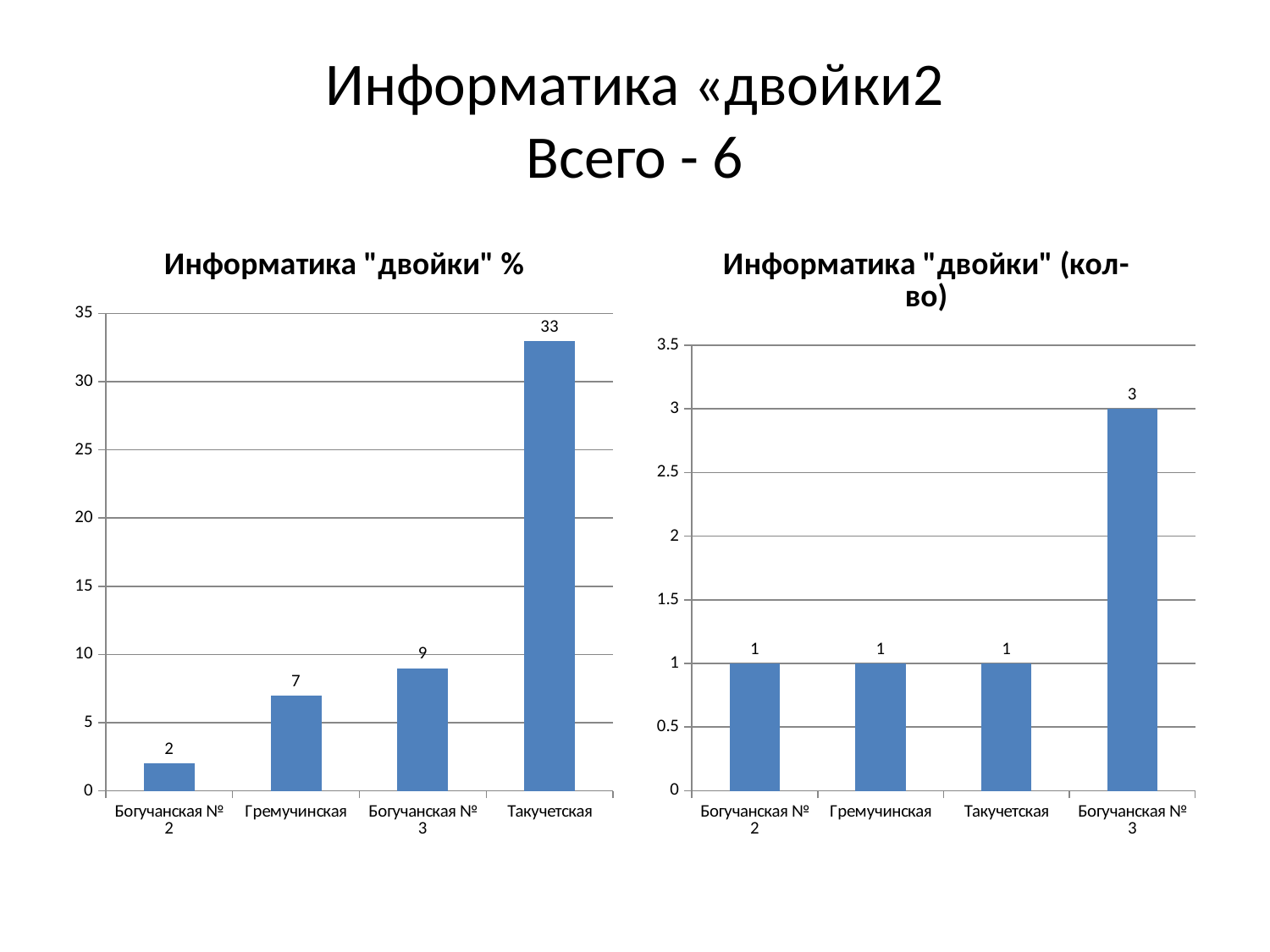
In the left chart (Информатика "двойки" %), what is the value for Такучетская? 33 In the left chart (Информатика "двойки" %), what is the difference between the values for Такучетская and Богучанская № 3? 24 In the right chart (Информатика "двойки" (кол-во)), which category has the highest value? Богучанская № 3 Do the values in the left chart (Информатика "двойки" %) rise or fall from left to right along the x axis? rise In the left chart (Информатика "двойки" %), which category has the lowest value? Богучанская № 2 In the left chart (Информатика "двойки" %), what is the value for Гремучинская? 7 In the left chart (Информатика "двойки" %), is the value for Такучетская greater or less than 30? greater In the right chart (Информатика "двойки" (кол-во)), what is the value for Богучанская № 3? 3 In the left chart (Информатика "двойки" %), which category has the highest value? Такучетская What type of chart is the left chart (Информатика "двойки" %)? bar chart In the right chart (Информатика "двойки" (кол-во)), which is larger: the value for Гремучинская or the value for Богучанская № 3? Богучанская № 3 How many categories are shown in the right chart (Информатика "двойки" (кол-во))? 4